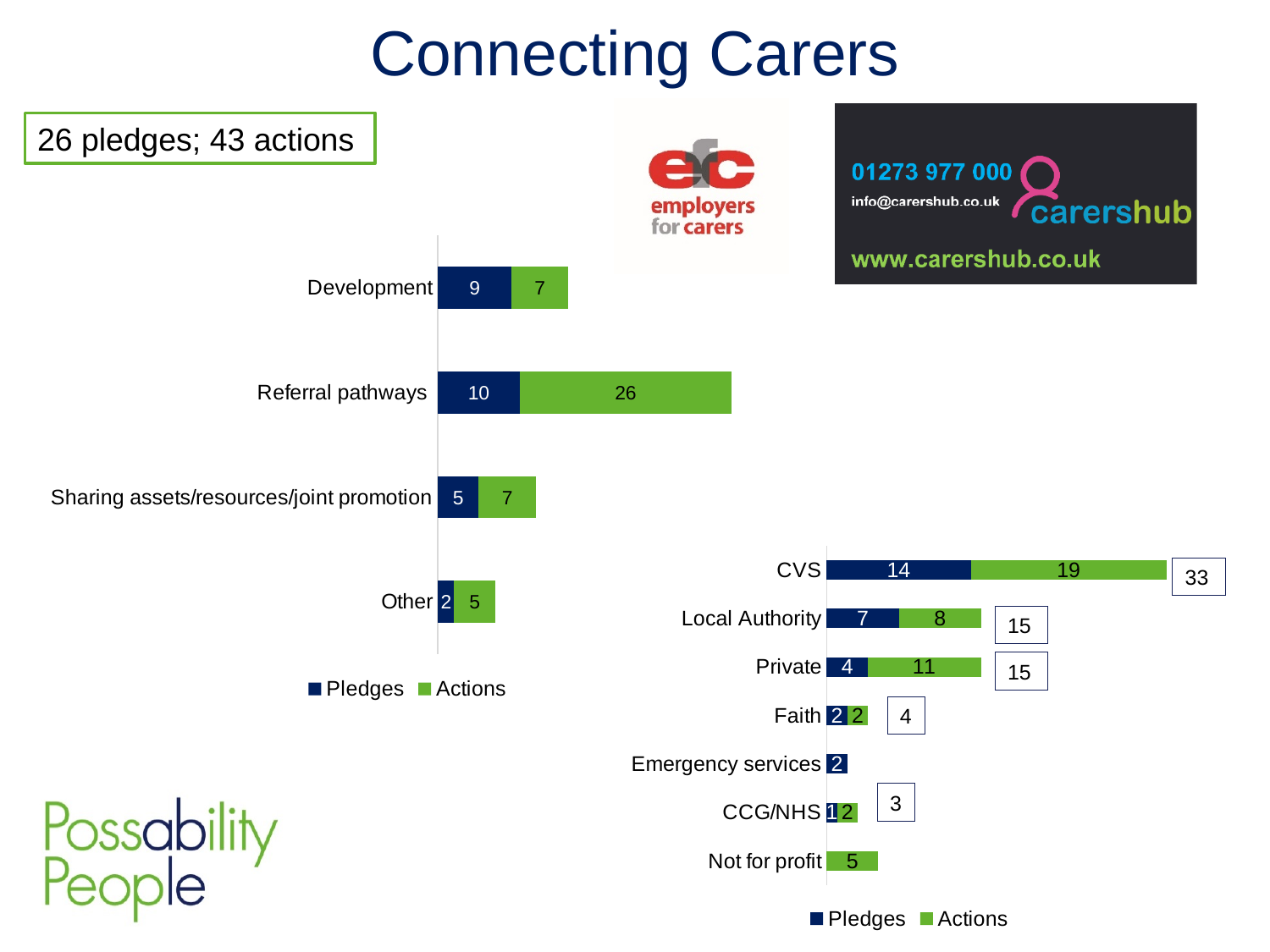
What kind of chart is the chart on the right of the slide? Stacked bar chart In the chart on the left of the slide, how many Actions are shown for Referral pathways? 26 In the chart on the left of the slide, what is the total of Pledges and Actions for Referral pathways? 36 In the chart on the left of the slide, how many Pledges are shown for Development? 9 In the chart on the right of the slide, how many Actions are shown for Private? 11 In the chart on the left of the slide, how many categories are plotted? 4 In the chart on the left of the slide, which category has the highest number of Actions? Referral pathways In the chart on the right of the slide, what is the difference between the Actions for CVS and the Actions for Local Authority? 11 In the chart on the left of the slide, which category has the lowest number of Pledges? Other In the chart on the right of the slide, how many Pledges are shown for CVS? 14 In the chart on the right of the slide, how many categories are plotted? 7 In the chart on the right of the slide, which has more Pledges, Local Authority or Private? Local Authority